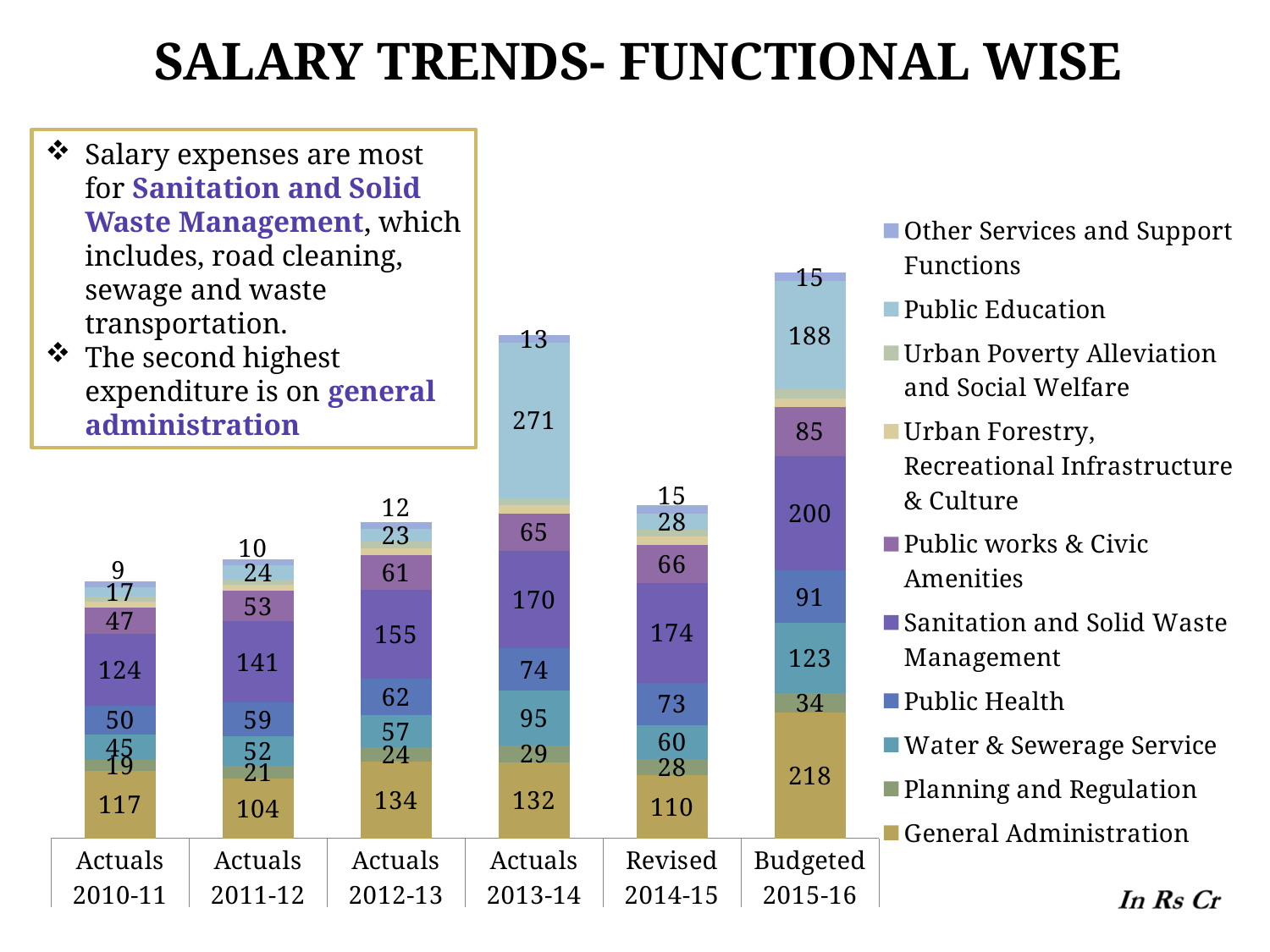
What is the value for Sanitation and Solid Waste Management in Revised 2014-15? 174 Do the Sanitation and Solid Waste Management values rise or fall from Actuals 2010-11 to Budgeted 2015-16? Rise How many periods are shown on the x axis? 6 Which period has the lowest value for General Administration? Actuals 2011-12 Which period has the highest value for Sanitation and Solid Waste Management? Budgeted 2015-16 What is the value for Other Services and Support Functions in Actuals 2012-13? 12 Which is larger: Water & Sewerage Service in Actuals 2013-14 or in Revised 2014-15? Actuals 2013-14 What is the value for Public Education in Actuals 2013-14? 271 What is the difference between the Sanitation and Solid Waste Management values for Budgeted 2015-16 and Actuals 2010-11? 76 What kind of chart is shown on the slide? Stacked bar chart How many series does the legend list? 10 What is the value for General Administration in Budgeted 2015-16? 218